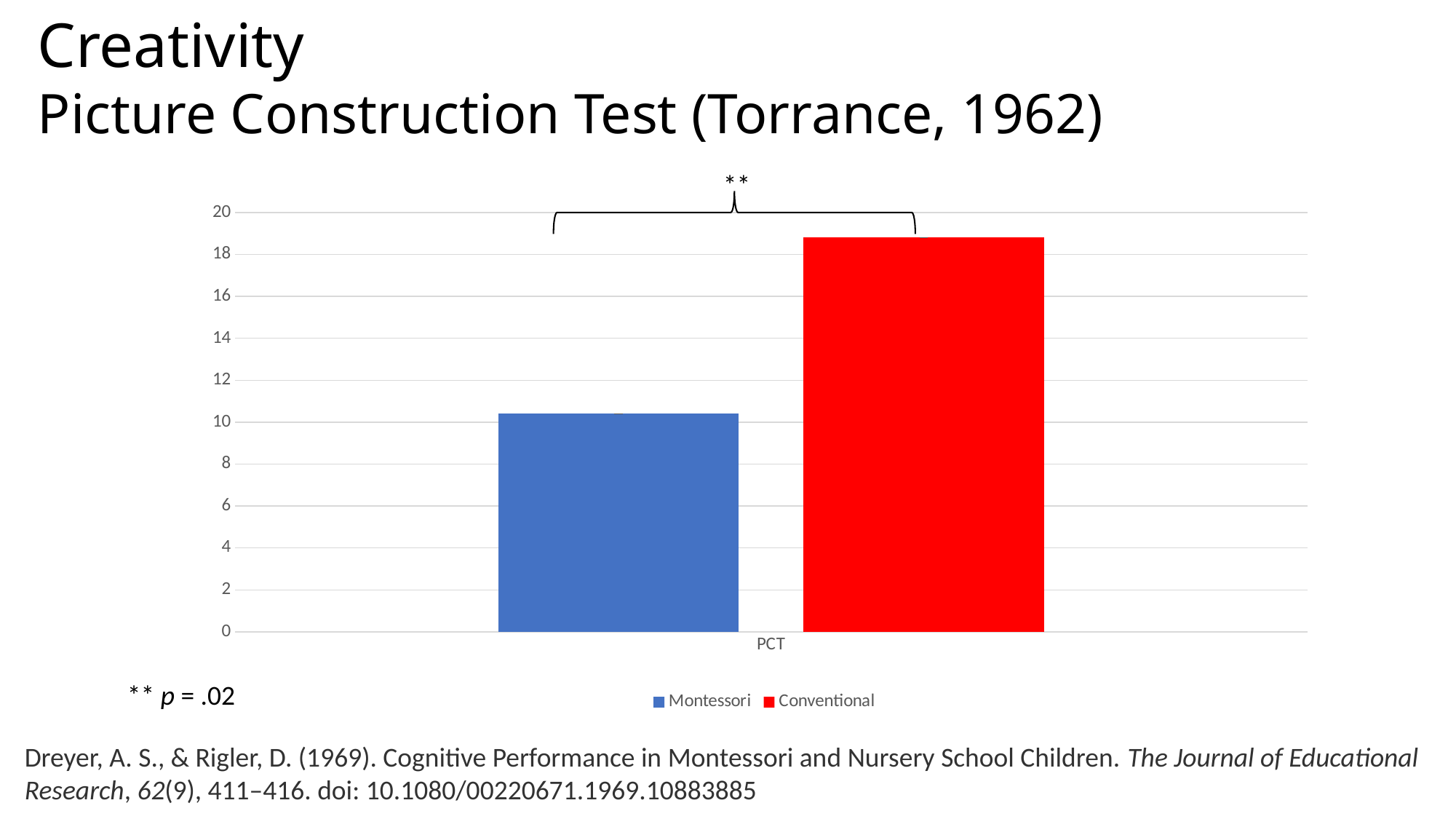
Which series has the higher value for PCT? Conventional Is the value for Montessori greater or less than 8? greater Which series has the lower value for PCT? Montessori What colour is the Conventional series in the chart? red Is the value for Conventional greater or less than 18? greater Is the value for Montessori greater or less than 12? less Is the Montessori bar or the Conventional bar taller? Conventional What kind of chart is shown on the slide? bar chart How many categories are shown on the x axis? 1 What is the label of the category on the x axis? PCT How many series does the legend list? 2